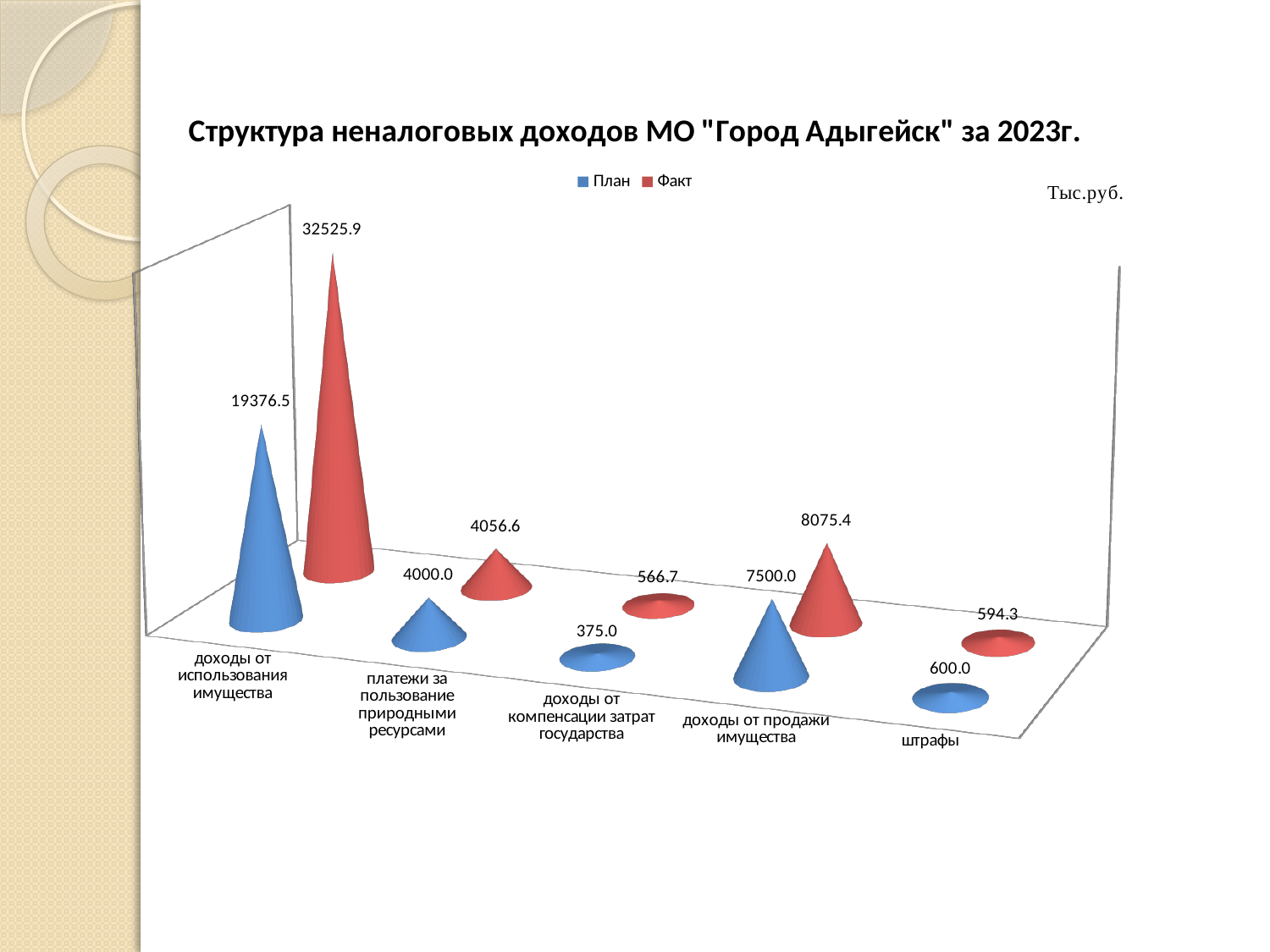
What is the Факт value for доходы от использования имущества? 32525.9 What is the Факт value for доходы от компенсации затрат государства? 566.7 What is the title of the chart? Структура неналоговых доходов МО "Город Адыгейск" за 2023г. Which category has the lowest План value? доходы от компенсации затрат государства What is the План value for доходы от продажи имущества? 7500.0 What is the difference between the Факт and План values for доходы от продажи имущества? 575.4 What is the План value for штрафы? 600.0 How many series does the legend list? 2 What is the difference between the Факт and План values for доходы от использования имущества? 13149.4 For штрафы, which is larger: the План value or the Факт value? План How many categories are shown on the chart? 5 Which category has the highest Факт value? доходы от использования имущества